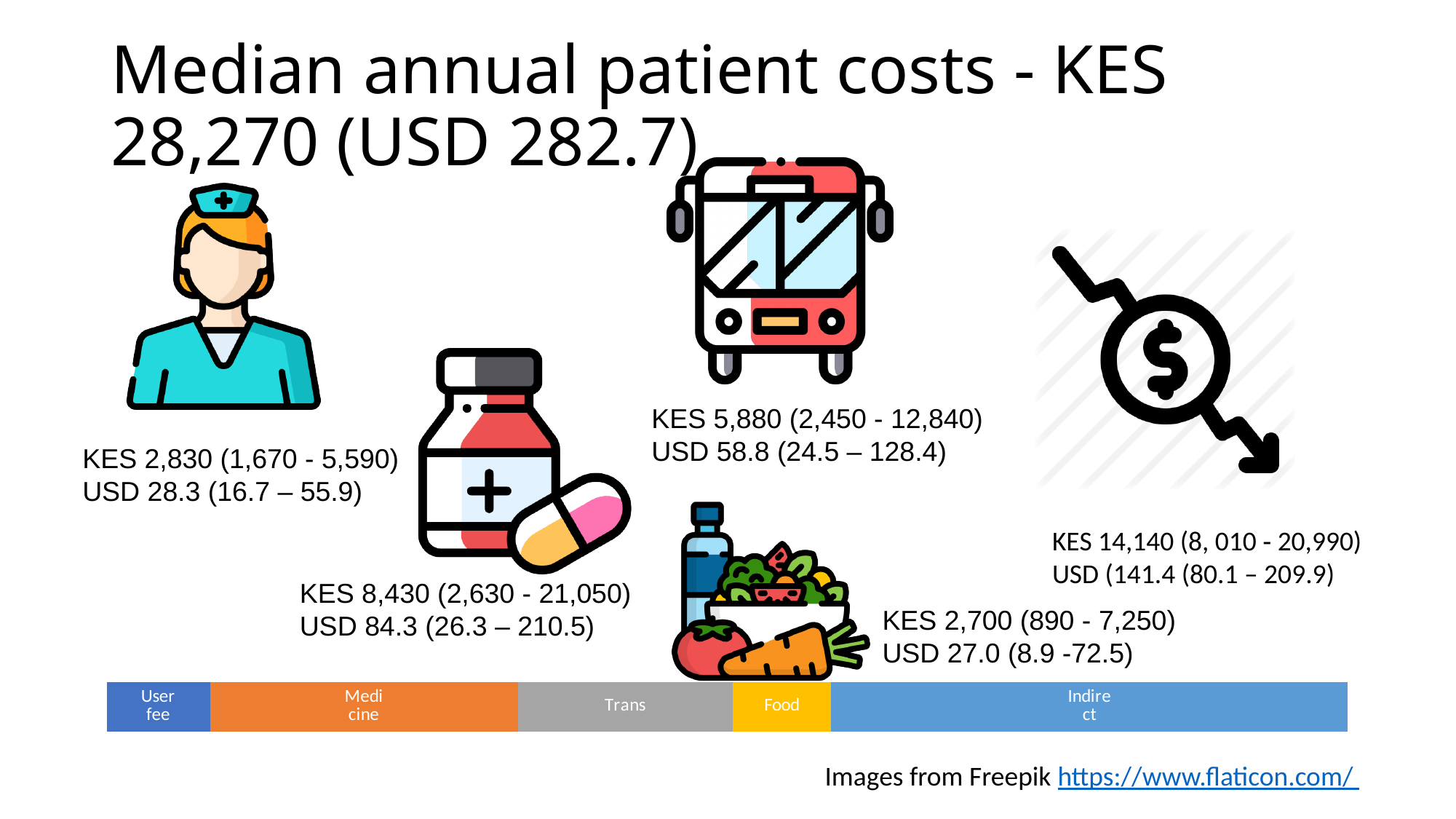
Which cost category has the largest segment in the stacked bar? Indirect How many cost categories are shown as segments in the stacked bar? 5 What is the median annual cost in KES for the Indirect category? KES 14,140 Which segment is larger in the stacked bar, Indirect or Medicine? Indirect What colour is the Food segment in the stacked bar? Yellow Which segment is larger in the stacked bar, Medicine or Trans? Medicine What is the median annual transport (Trans) cost in USD? USD 58.8 What is the difference in KES between the Indirect cost (14,140) and the Medicine cost (8,430)? KES 5,710 What is the median annual cost in KES for the Medicine category? KES 8,430 What is the total median annual patient cost in KES shown in the title? KES 28,270 What kind of chart is shown at the bottom of the slide? Stacked bar chart What is the median annual user fee cost in KES? KES 2,830